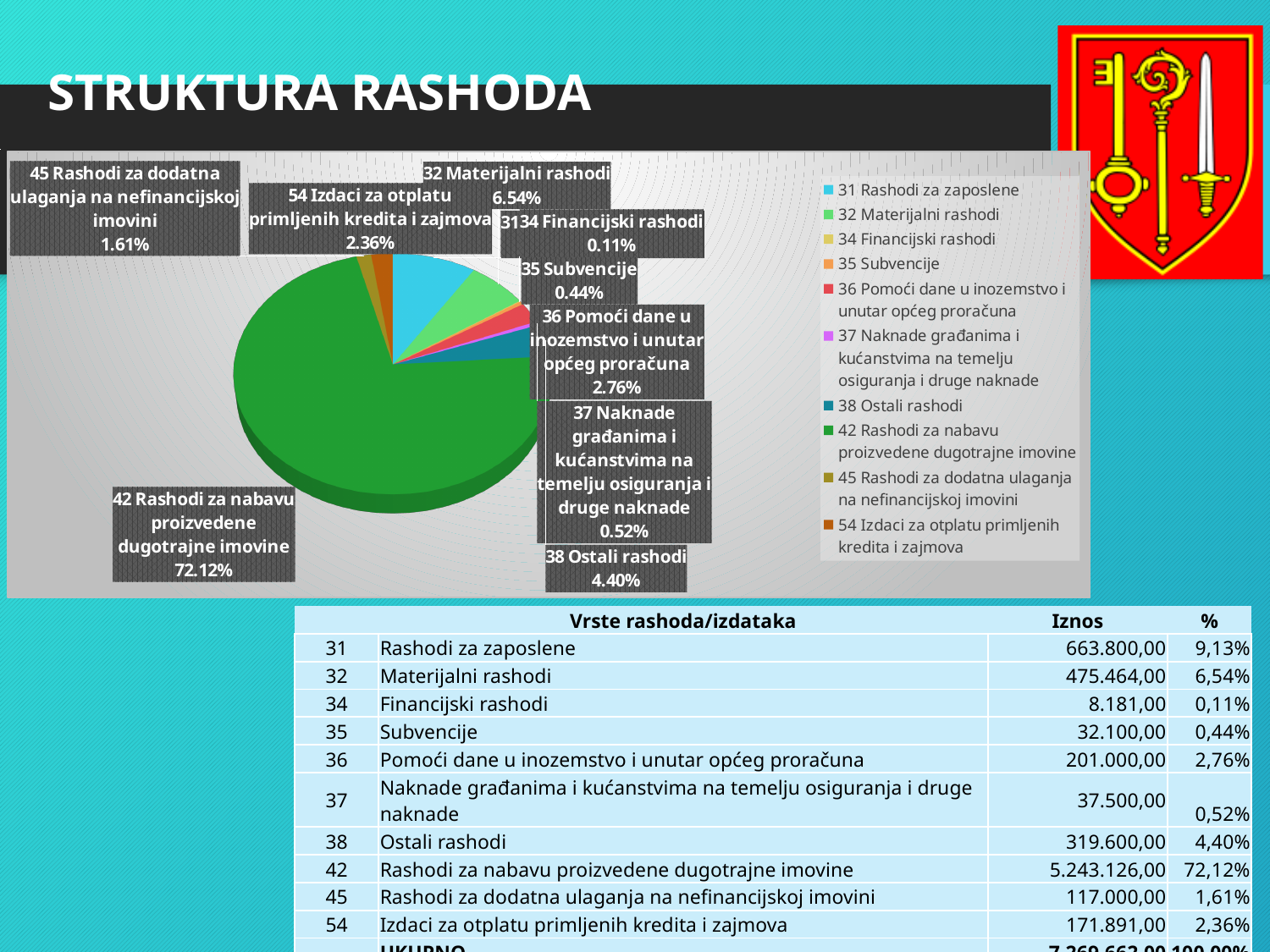
How many entries does the legend of the pie chart list? 10 What is the title of the slide containing the pie chart? STRUKTURA RASHODA What share of the pie does '42 Rashodi za nabavu proizvedene dugotrajne imovine' have? 72.12% Which is larger in the pie chart: '38 Ostali rashodi' or '36 Pomoći dane u inozemstvo i unutar općeg proračuna'? 38 Ostali rashodi What is the difference in percentage points between '32 Materijalni rashodi' and '38 Ostali rashodi' in the pie chart? 2.14% What percentage is shown for '32 Materijalni rashodi' in the pie chart? 6.54% What percentage is shown for '54 Izdaci za otplatu primljenih kredita i zajmova' in the pie chart? 2.36% What percentage is shown for '35 Subvencije' in the pie chart? 0.44% Which category has the largest slice of the pie chart? 42 Rashodi za nabavu proizvedene dugotrajne imovine What kind of chart is shown on the slide? Pie chart Which category has the smallest slice of the pie chart? 34 Financijski rashodi What percentage is shown for '38 Ostali rashodi' in the pie chart? 4.40%